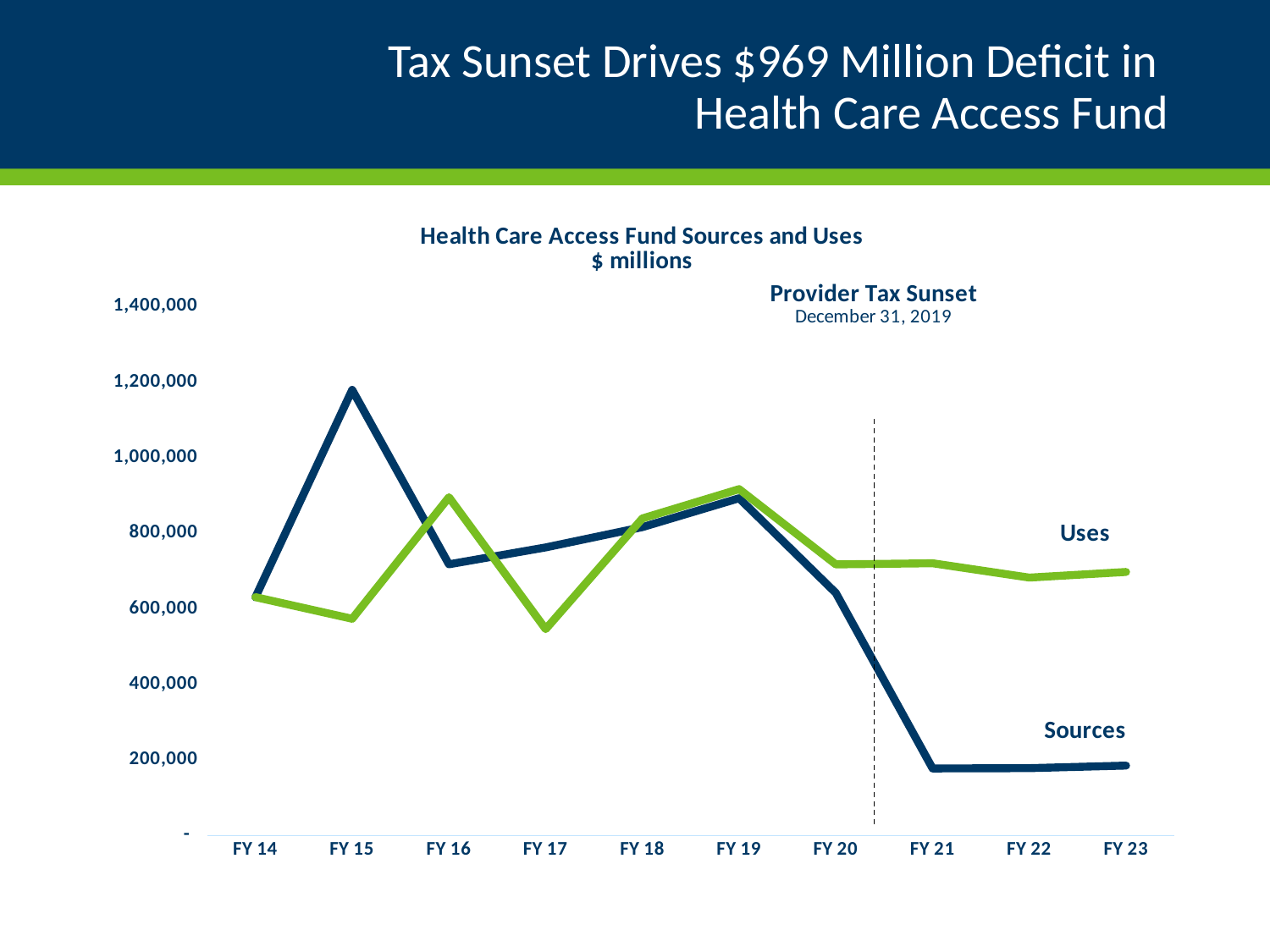
How many fiscal years are plotted along the x axis? 10 What kind of chart is shown on the slide? Line chart In which fiscal year does the Uses line reach its lowest value? FY 17 Is the value for Sources in FY 15 greater or less than 1,000,000? greater In FY 21, which is larger, Sources or Uses? Uses Is the value for Uses in FY 17 greater or less than 600,000? less Does the Sources line rise or fall from FY 19 to FY 21? Fall How many series are plotted on the chart? 2 What is the title of the chart? Health Care Access Fund Sources and Uses In which fiscal year does the Sources line reach its highest value? FY 15 What event does the dashed vertical line on the chart mark? Provider Tax Sunset, December 31, 2019 Is the value for Sources in FY 21 greater or less than 200,000? less